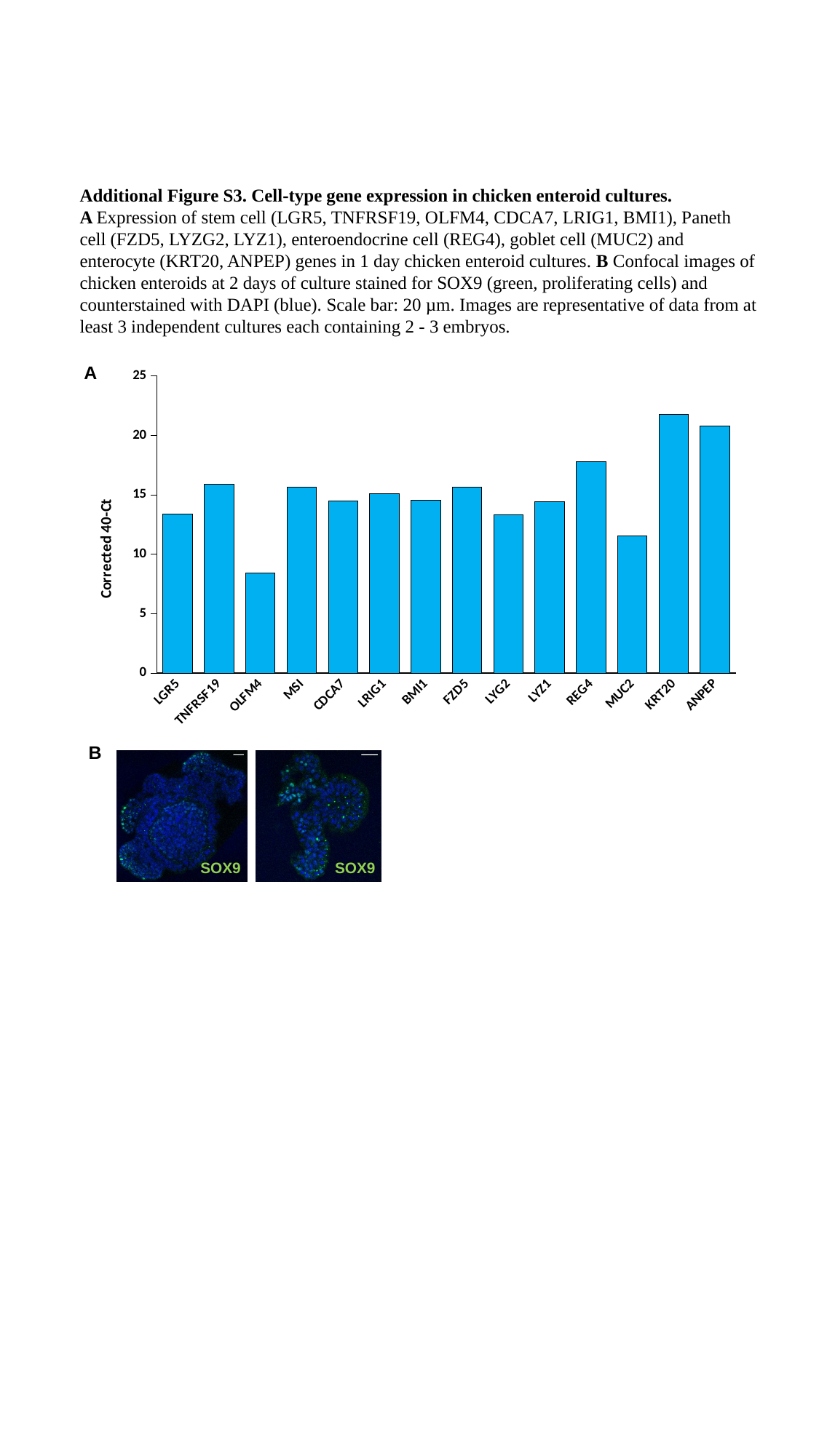
In the panel A chart, is the value for LGR5 greater or less than 15? less What kind of chart is shown in panel A? bar chart In the panel A chart, which has the larger Corrected 40-Ct value, OLFM4 or LGR5? LGR5 How many genes (bars) are plotted in the panel A chart? 14 In the panel A chart, is the value for OLFM4 greater or less than 10? less In the panel A chart, which gene has the lowest Corrected 40-Ct value? OLFM4 In the panel A chart, is the value for MUC2 greater or less than 15? less What is the y-axis label of the panel A chart? Corrected 40-Ct In the panel A chart, which has the larger Corrected 40-Ct value, REG4 or MUC2? REG4 In the panel A chart, which gene has the highest Corrected 40-Ct value? KRT20